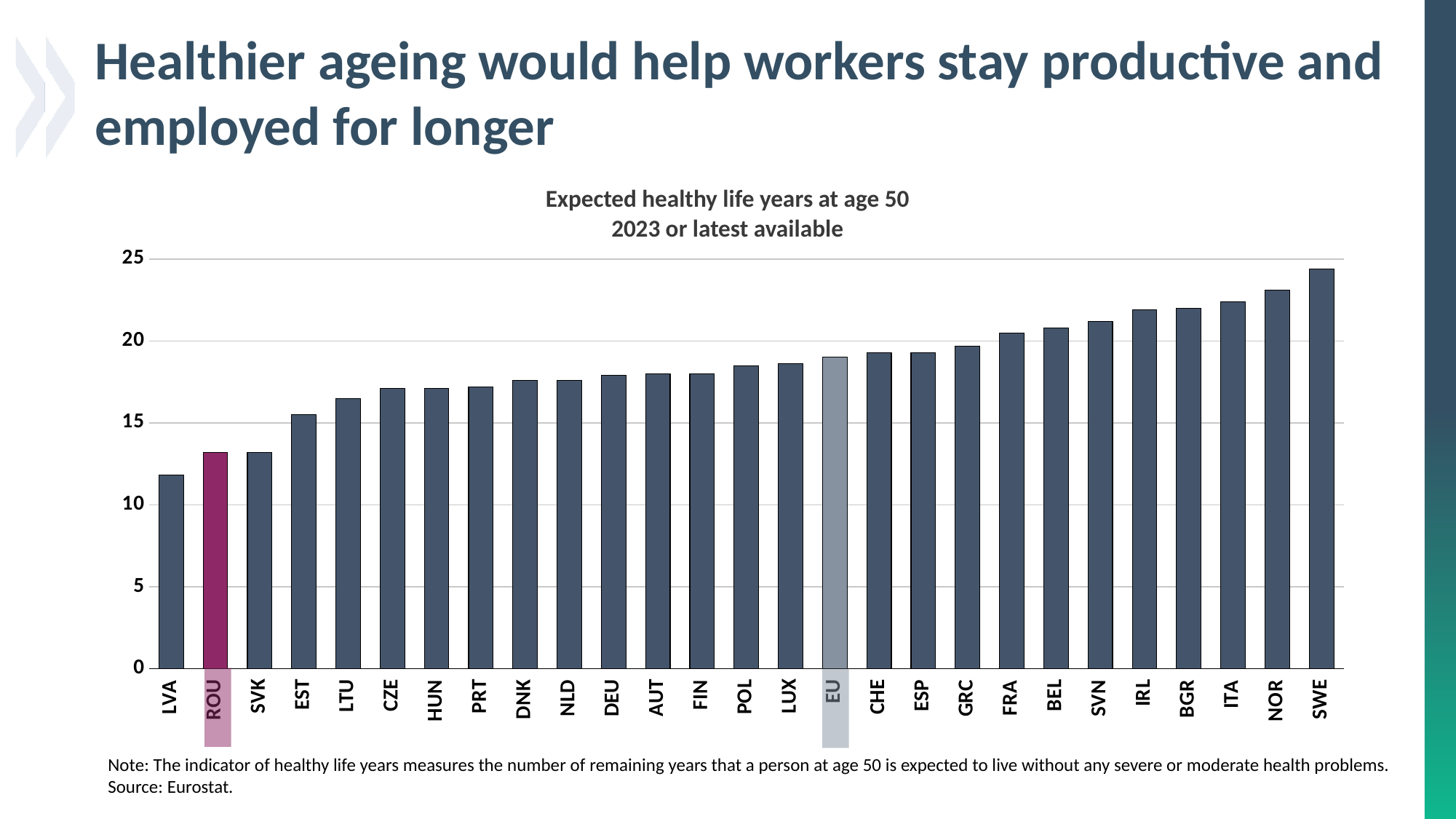
Is the value for FRA greater or less than 20? greater Which country has the highest expected healthy life years at age 50? SWE Is the value for EU greater or less than 20? less Which has the larger value, FRA or EU? FRA Is the value for LVA greater or less than 15? less How many bars are plotted in the chart? 27 What kind of chart is shown on the slide? Bar chart Do the values rise or fall moving from left to right along the x axis? Rise Which country has the lowest expected healthy life years at age 50? LVA Which country's bar is highlighted in a purple/magenta colour? ROU Which has the larger value, ITA or CHE? ITA